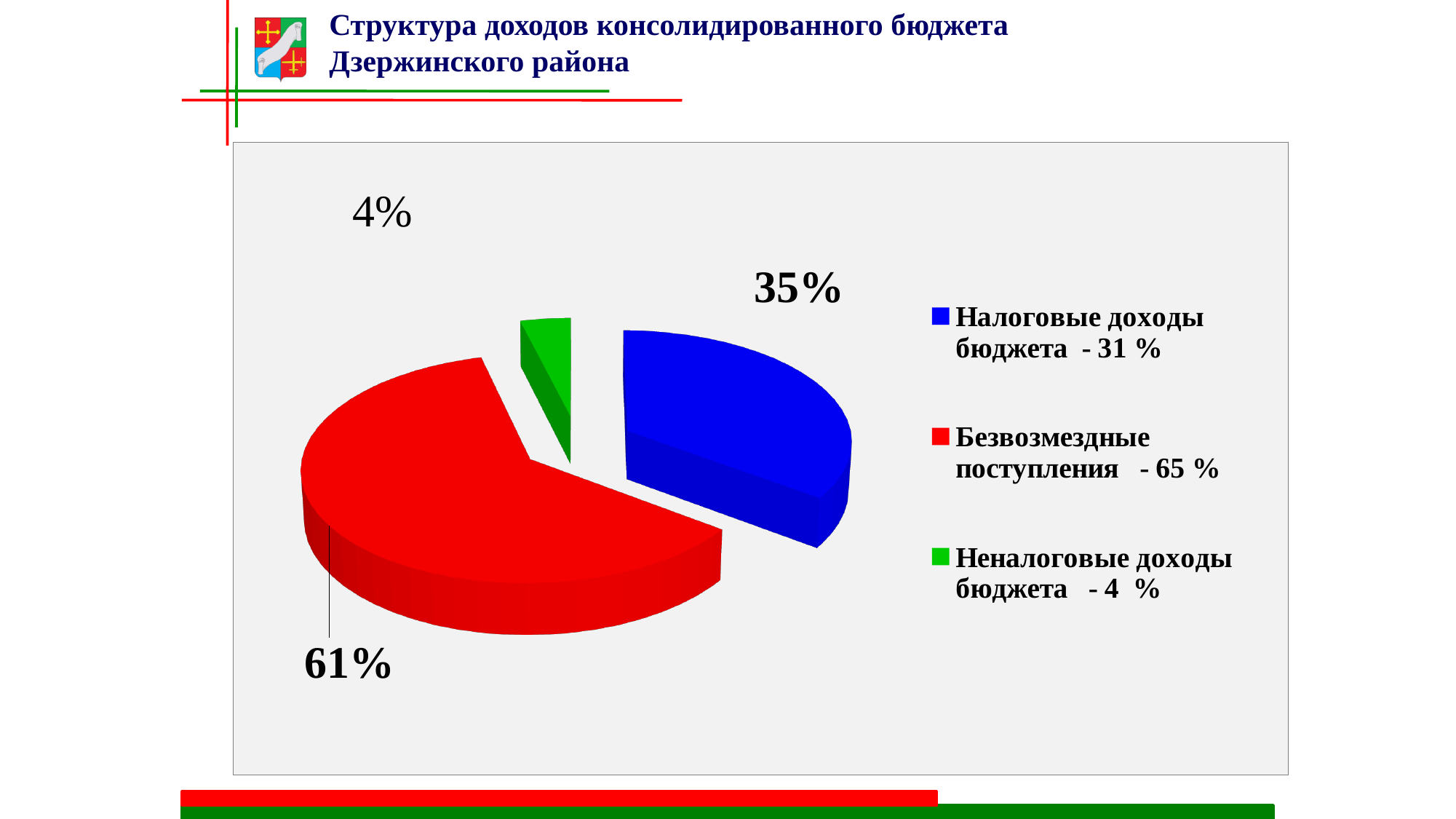
Which slice is larger: the blue one (Налоговые доходы бюджета) or the green one (Неналоговые доходы бюджета)? Налоговые доходы бюджета How many entries does the legend list? 3 Which category has the largest slice of the pie? Безвозмездные поступления What data label is shown on the blue slice (Налоговые доходы бюджета)? 35% What percentage does the legend text state for Налоговые доходы бюджета? 31 % What data label is shown on the green slice (Неналоговые доходы бюджета)? 4% What data label is shown on the red slice (Безвозмездные поступления)? 61% According to the data labels, what is the difference between the red slice (61%) and the blue slice (35%)? 26% Which category has the smallest slice of the pie? Неналоговые доходы бюджета How many slices does the pie chart have? 3 What kind of chart is shown on the slide? pie chart What colour represents Безвозмездные поступления in the chart? red